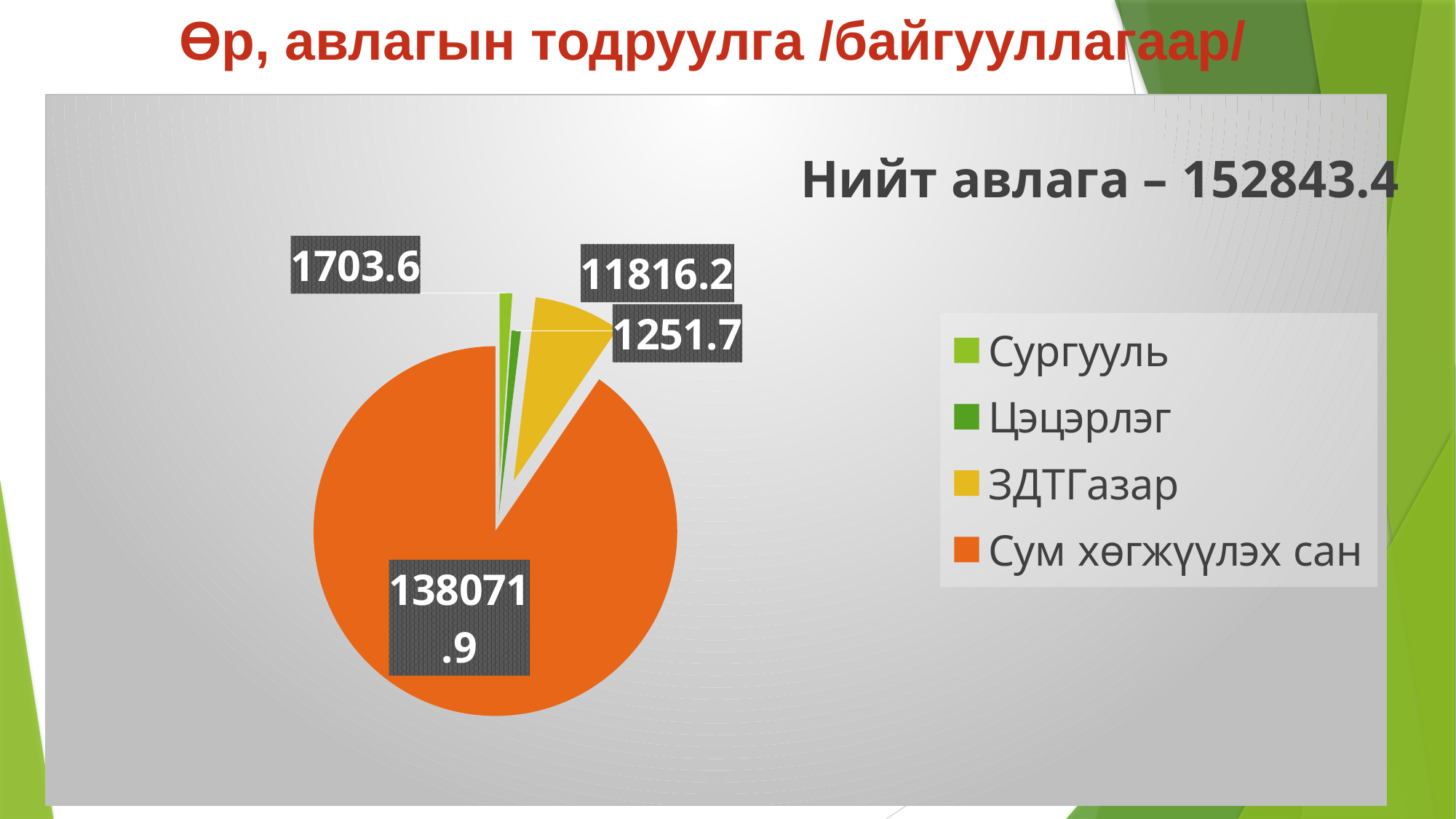
What is the value for Сургууль? 1703.6 Which category has the largest slice of the pie? Сум хөгжүүлэх сан What total is stated on the slide next to 'Нийт авлага'? 152843.4 What kind of chart is shown on the slide? pie chart How many categories does the pie chart have? 4 What is the difference between the values for ЗДТГазар and Цэцэрлэг? 10564.5 What is the difference between the values for Сургууль and Цэцэрлэг? 451.9 Which category has the smallest slice of the pie? Цэцэрлэг What is the value for Сум хөгжүүлэх сан? 138071.9 Which is larger, the value for Сургууль or the value for ЗДТГазар? ЗДТГазар What is the value for ЗДТГазар? 11816.2 What is the value for Цэцэрлэг? 1251.7